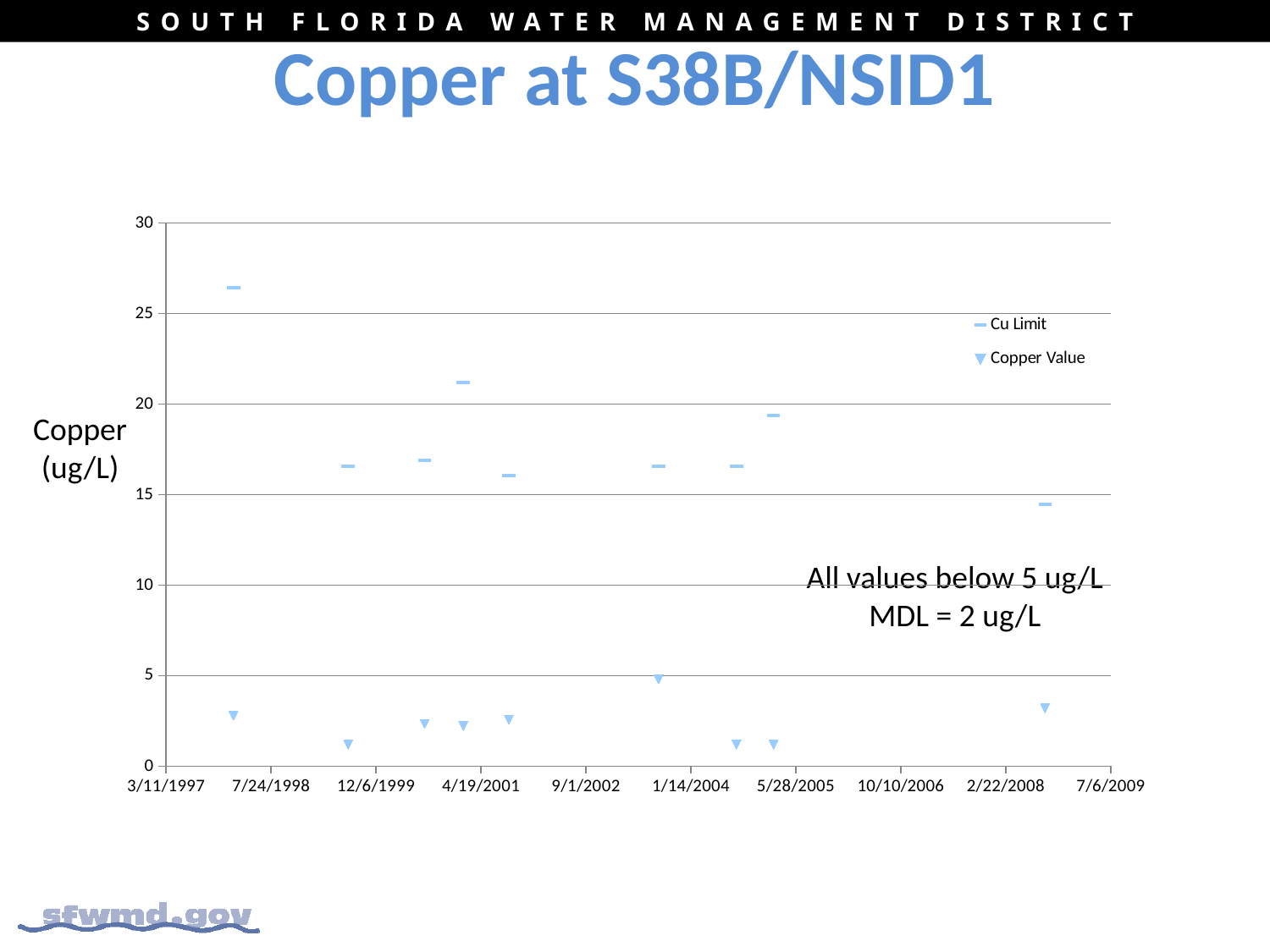
What is the label on the vertical axis? Copper (ug/L) Around which x-axis date does the highest Cu Limit point occur? 7/24/1998 Which series has the higher values throughout the chart, Cu Limit or Copper Value? Cu Limit Is the Cu Limit point plotted near 5/28/2005 greater or less than 15? greater What are the two series named in the legend? Cu Limit and Copper Value Is the highest Cu Limit point greater or less than 25? greater What kind of chart is shown on the slide? scatter chart How many series does the legend list? 2 Is the Copper Value point plotted near 7/24/1998 greater or less than 5? less Around which x-axis date does the highest Copper Value point occur? 1/14/2004 Is the first Cu Limit point (near 7/24/1998) larger or smaller than the Cu Limit point near 4/19/2001? larger